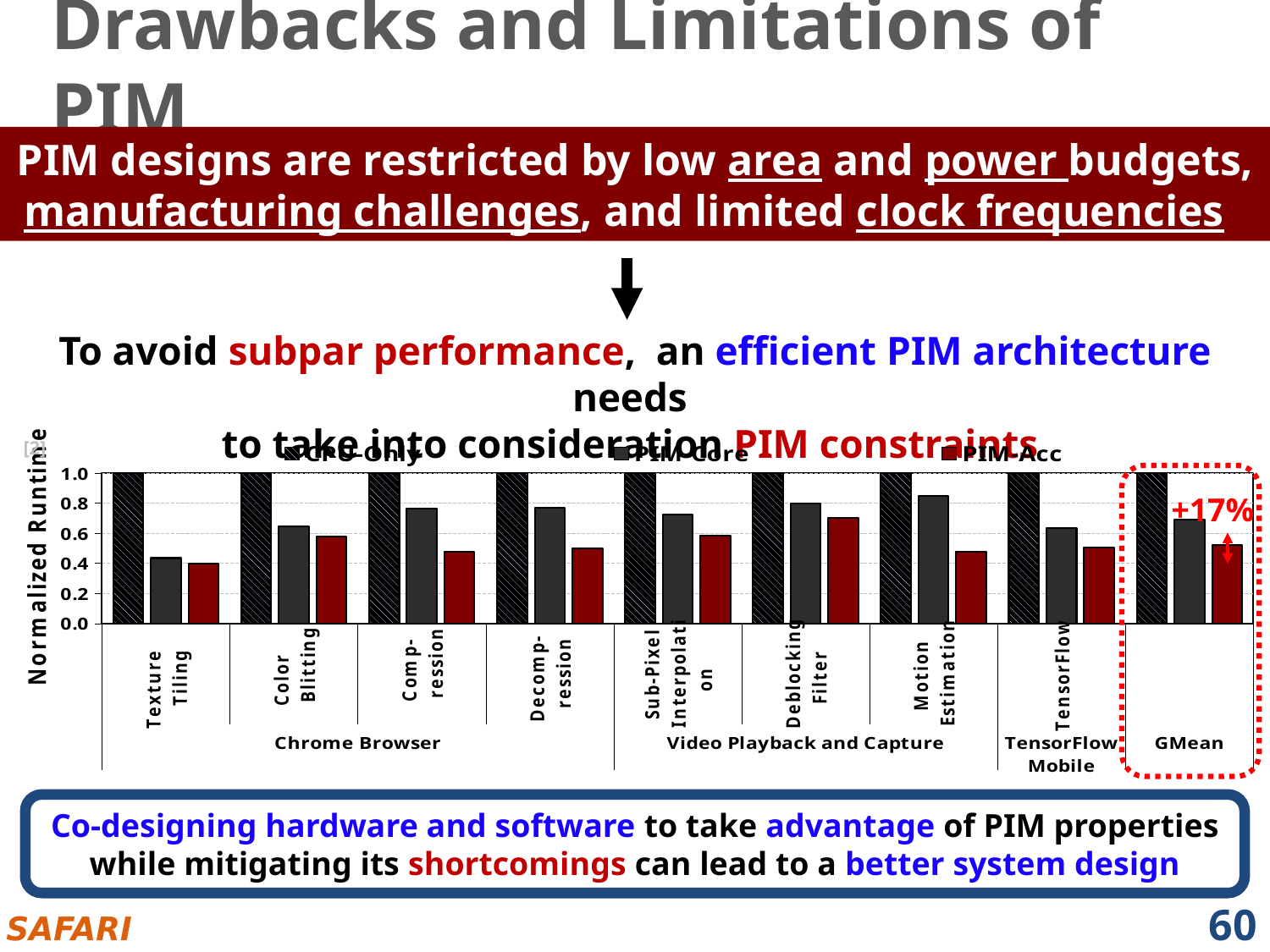
For Compression, which is larger: the PIM-Core value or the PIM-Acc value? PIM-Core What kind of chart is shown on the slide? bar chart Is the PIM-Core value for Texture Tiling greater or less than 0.6? less What is the CPU-Only normalized runtime for Texture Tiling? 1.0 How many workload categories are plotted along the x axis of the chart? 9 Is the PIM-Core value for TensorFlow greater or less than 0.4? greater What is the CPU-Only normalized runtime for GMean? 1.0 What is the label of the chart's y axis? Normalized Runtime Is the PIM-Acc value for Deblocking Filter greater or less than 0.6? greater Which category has the highest PIM-Core normalized runtime? Motion Estimation How many series does the chart's legend list? 3 For Motion Estimation, which is larger: the PIM-Core value or the PIM-Acc value? PIM-Core